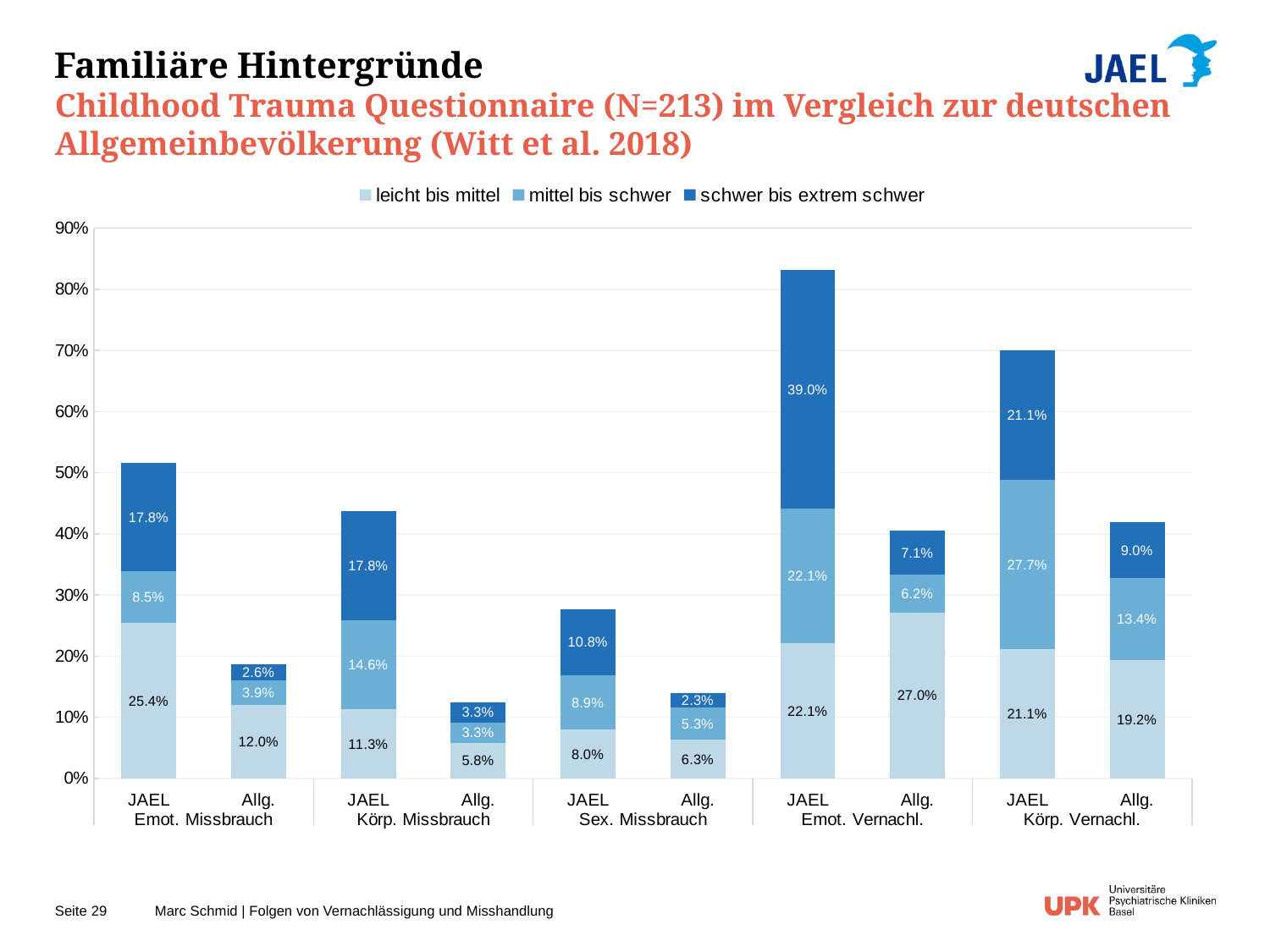
How many series does the legend list? 3 What is the 'mittel bis schwer' value for Allg. in Körp. Vernachl.? 13.4% Which bar has the lowest total? Allg. Körp. Missbrauch How many bars are plotted in the chart? 10 What is the difference between the 'schwer bis extrem schwer' values for JAEL and Allg. in Emot. Vernachl.? 31.9% What is the total of the stacked bar for JAEL in Körp. Vernachl.? 69.9% What is the 'schwer bis extrem schwer' value for JAEL in Emot. Vernachl.? 39.0% What is the 'leicht bis mittel' value for JAEL in Emot. Missbrauch? 25.4% Which bar has the highest total? JAEL Emot. Vernachl. Is the total for JAEL in Emot. Vernachl. greater or less than 80%? greater What is the 'schwer bis extrem schwer' value for Allg. in Sex. Missbrauch? 2.3% What kind of chart is shown on the slide? Stacked bar chart